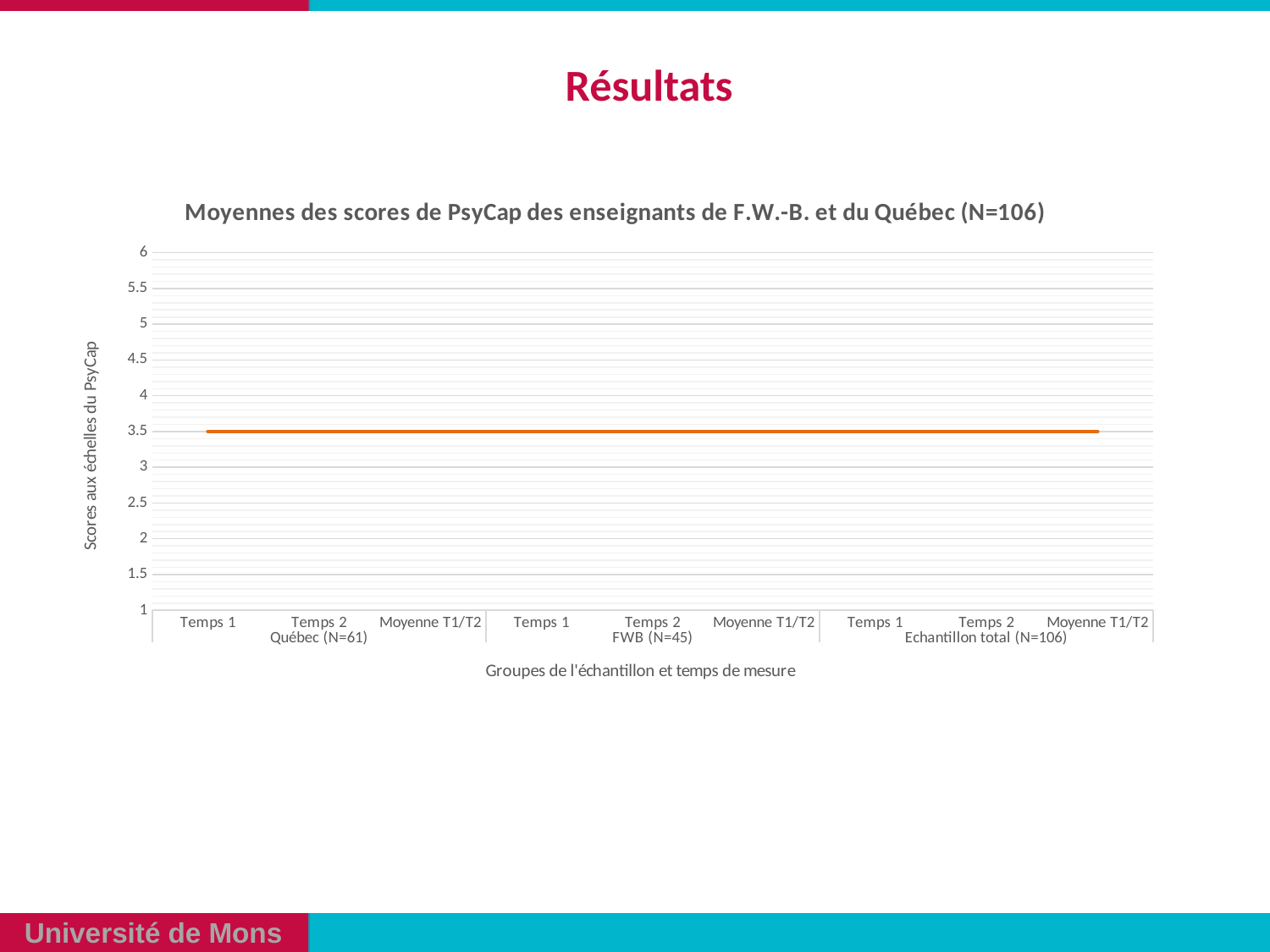
Is the value for Temps 1 in the Echantillon total (N=106) group greater or less than 2? greater Is the value for Temps 2 in the FWB (N=45) group greater or less than 4? less What is the title of the chart? Moyennes des scores de PsyCap des enseignants de F.W.-B. et du Québec (N=106) What is the lowest value shown on the vertical axis? 1 Is the value for Temps 1 in the Québec (N=61) group greater or less than 3? greater What kind of chart is shown on the slide? line chart What is the label of the vertical axis? Scores aux échelles du PsyCap Does the plotted line rise, fall, or stay flat across the x axis? stays flat How many categories are shown along the x axis? 9